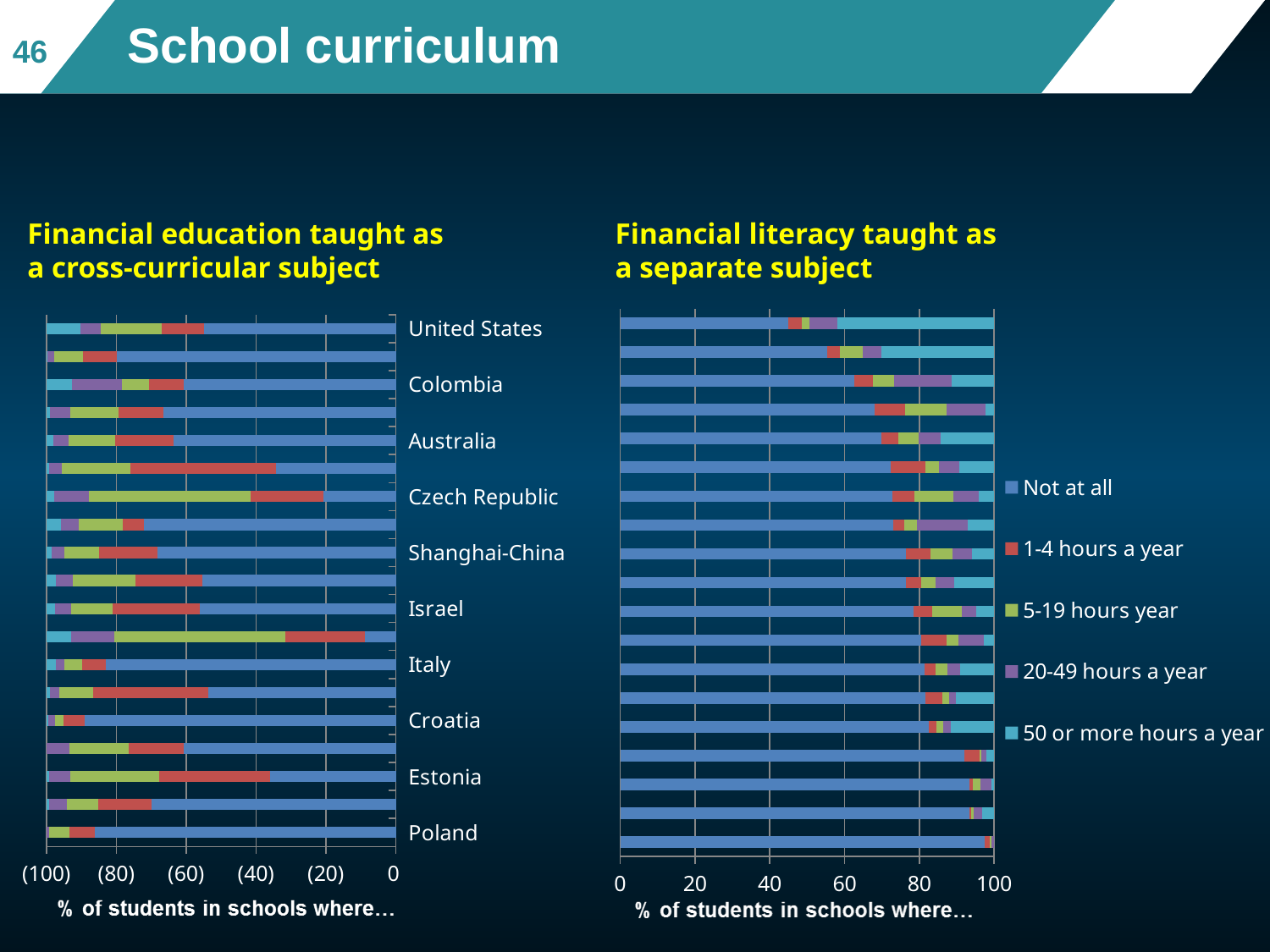
In the 'Financial literacy taught as a separate subject' chart, is the 'Not at all' value for Poland greater or less than 80? greater In the 'Financial literacy taught as a separate subject' chart, is the 'Not at all' value for the United States greater or less than 60? less What kind of chart is the 'Financial literacy taught as a separate subject' chart? Bar chart In the 'Financial literacy taught as a separate subject' chart, which labelled country has the largest 'Not at all' share? Poland In the 'Financial literacy taught as a separate subject' chart, which has the larger 'Not at all' value, Poland or the United States? Poland In the 'Financial literacy taught as a separate subject' chart, is the 'Not at all' value for Australia greater or less than 60? greater How many country labels are shown between the two charts? 10 In the 'Financial literacy taught as a separate subject' chart, does the 'Not at all' segment get longer or shorter moving down from the United States to Poland? Longer What is the title of the left chart? Financial education taught as a cross-curricular subject How many series does the legend list? 5 In the 'Financial literacy taught as a separate subject' chart, which labelled country has the smallest 'Not at all' share? United States Which legend entry is shown in blue? Not at all